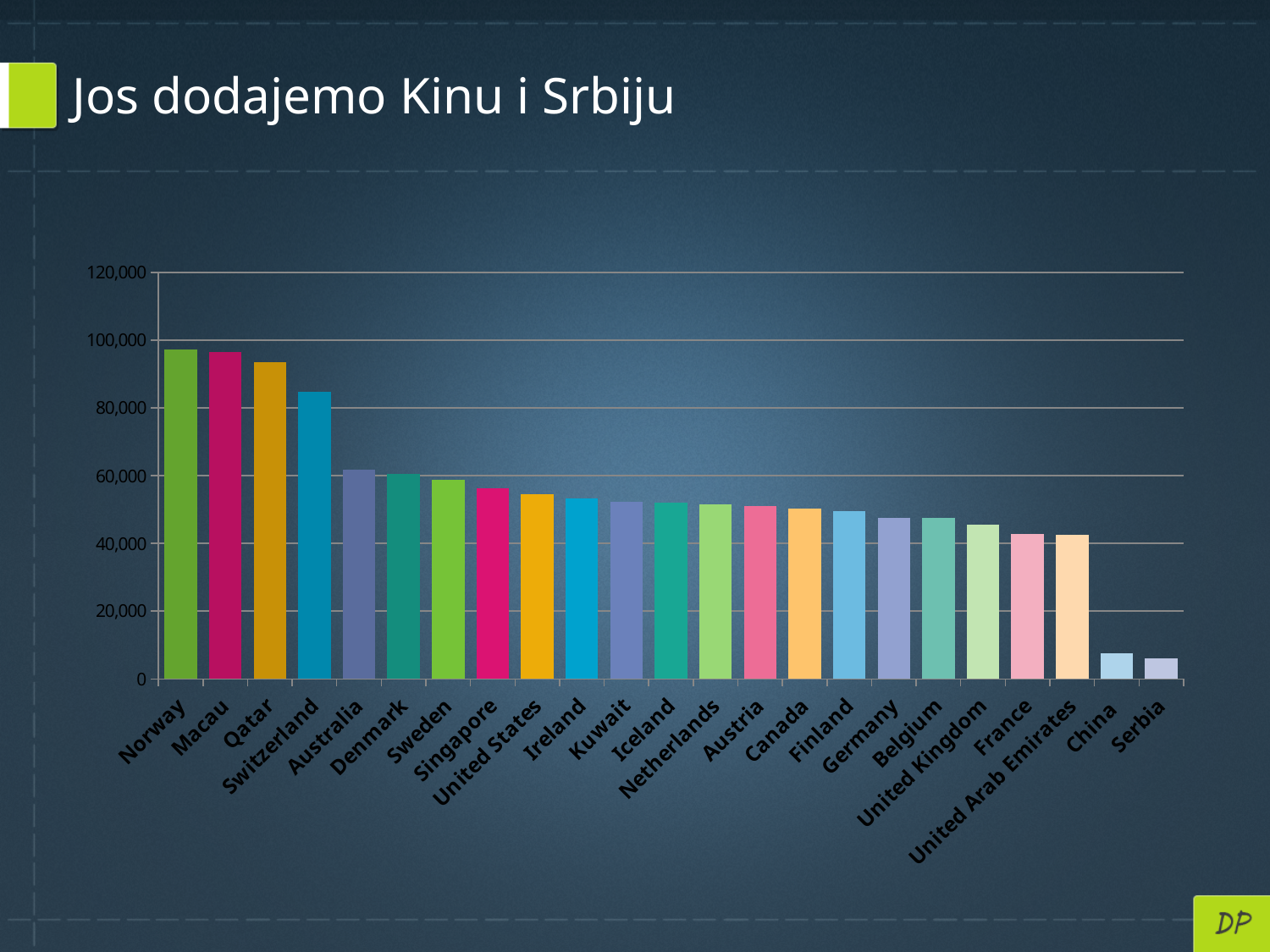
Do the values generally rise or fall moving from left to right along the x axis? fall How many countries are shown on the x axis of the chart? 23 Is the value for China greater or less than 20,000? less What is the title of the slide containing the chart? Jos dodajemo Kinu i Srbiju Which has the larger value, China or France? France Is the value for Qatar greater or less than 80,000? greater Is the value for Ireland greater or less than 60,000? less Which has the larger value, Norway or Switzerland? Norway What kind of chart is shown on the slide? bar chart Which country has the lowest value in the chart? Serbia